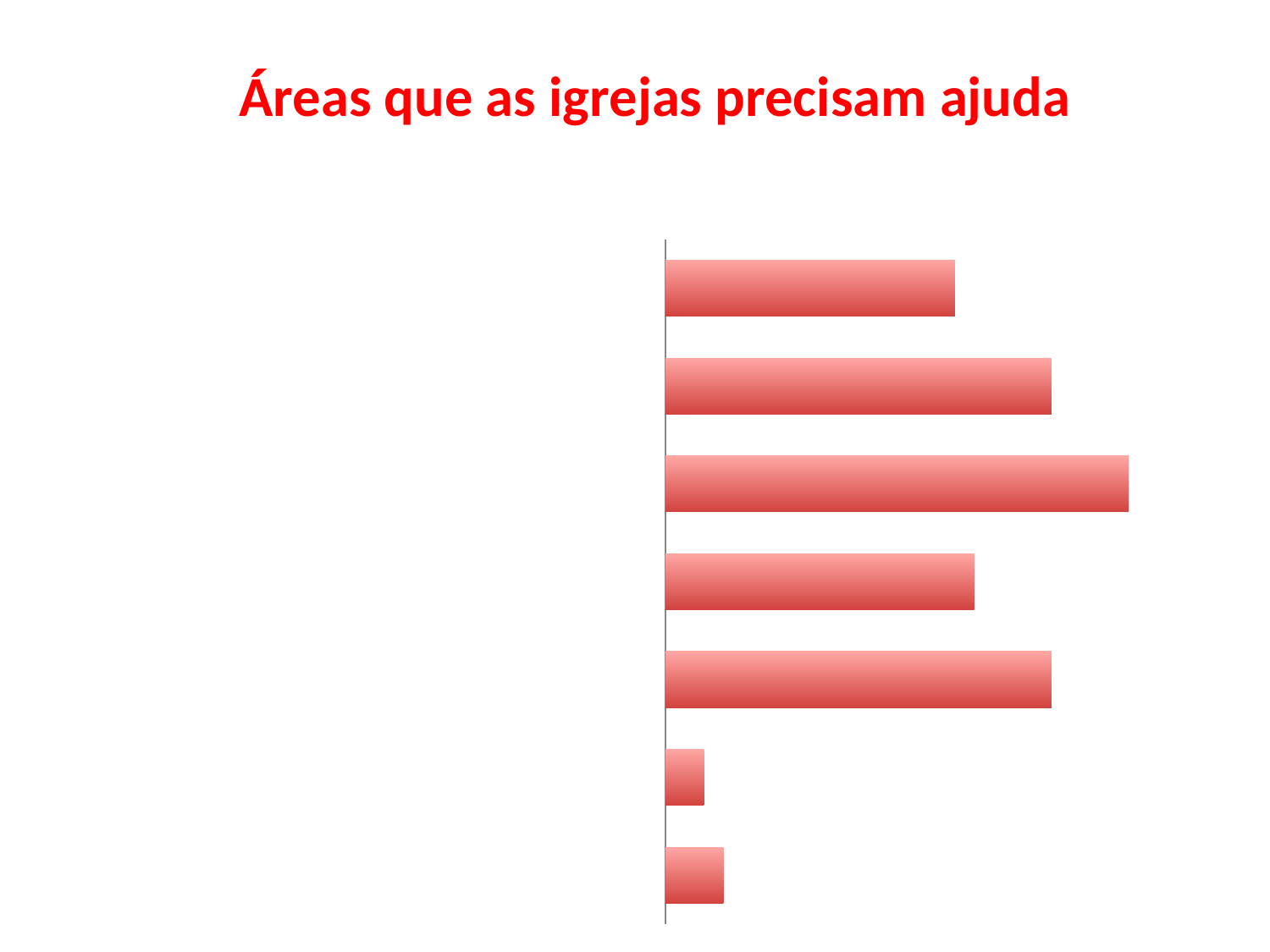
Are the bars in the chart horizontal or vertical? Horizontal What colour are the bars in the chart? Red Which is longer, the sixth bar from the top or the seventh bar from the top? The seventh bar Which is longer, the fourth bar from the top or the fifth bar from the top? The fifth bar Counting from the top, which bar is the longest? The third bar Which is longer, the first bar from the top or the second bar from the top? The second bar What kind of chart is shown on the slide? Bar chart What is the title of the chart on the slide? Áreas que as igrejas precisam ajuda Counting from the top, which bar is the shortest? The sixth bar How many bars does the chart contain? 7